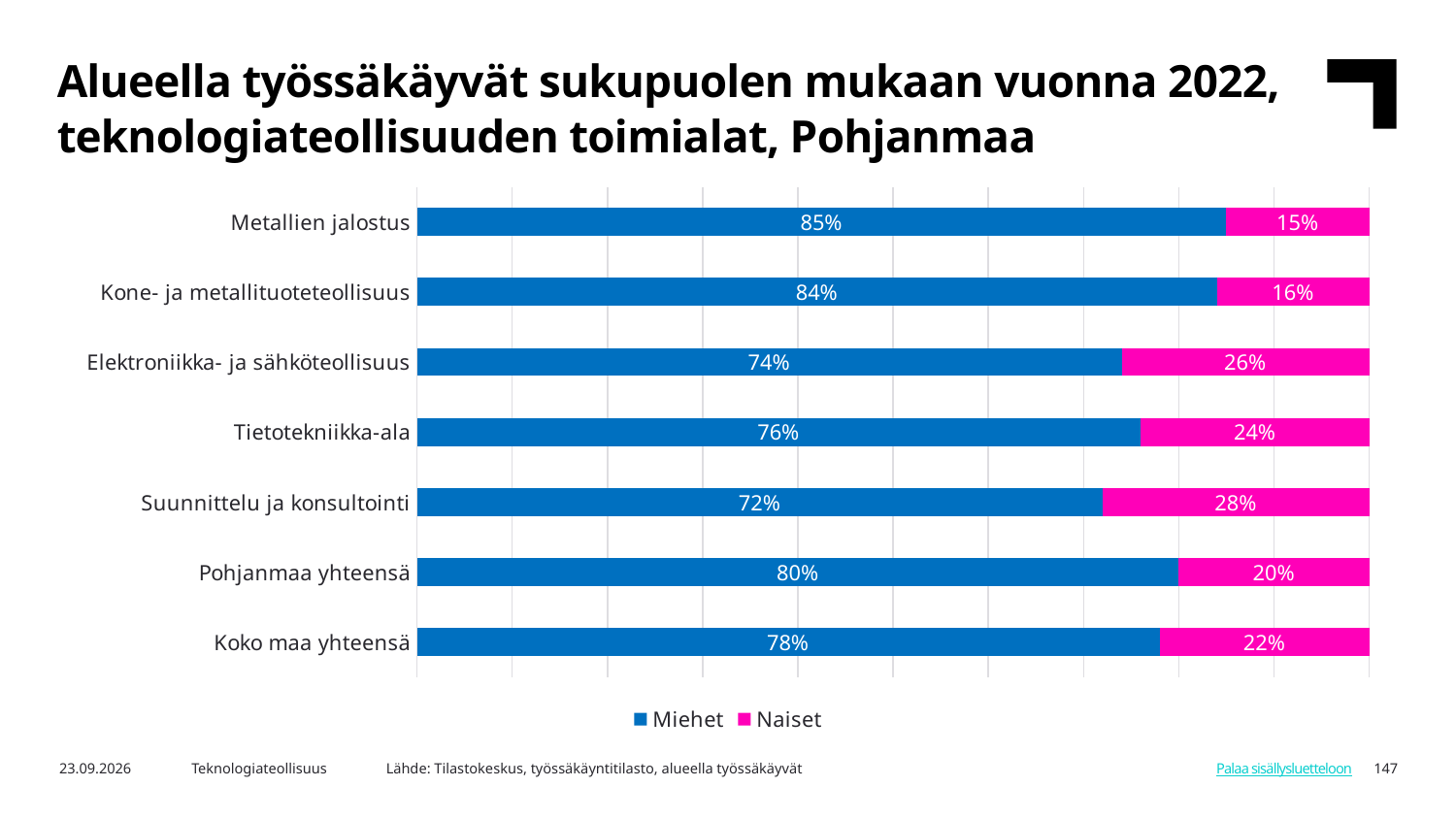
Which category has the highest Naiset share? Suunnittelu ja konsultointi What is the Naiset share for Suunnittelu ja konsultointi? 28% Which has a larger Naiset share, Elektroniikka- ja sähköteollisuus or Tietotekniikka-ala? Elektroniikka- ja sähköteollisuus How many categories are shown on the chart? 7 How many series does the legend list? 2 Which category has the lowest Naiset share? Metallien jalostus What kind of chart is shown on the slide? Stacked bar chart What is the Miehet share for Pohjanmaa yhteensä? 80% What is the Miehet share for Metallien jalostus? 85% What is the total of the stacked bar for Tietotekniikka-ala? 100% What is the difference between the Miehet share for Kone- ja metallituoteteollisuus and for Tietotekniikka-ala? 8 percentage points What is the Naiset share for Koko maa yhteensä? 22%